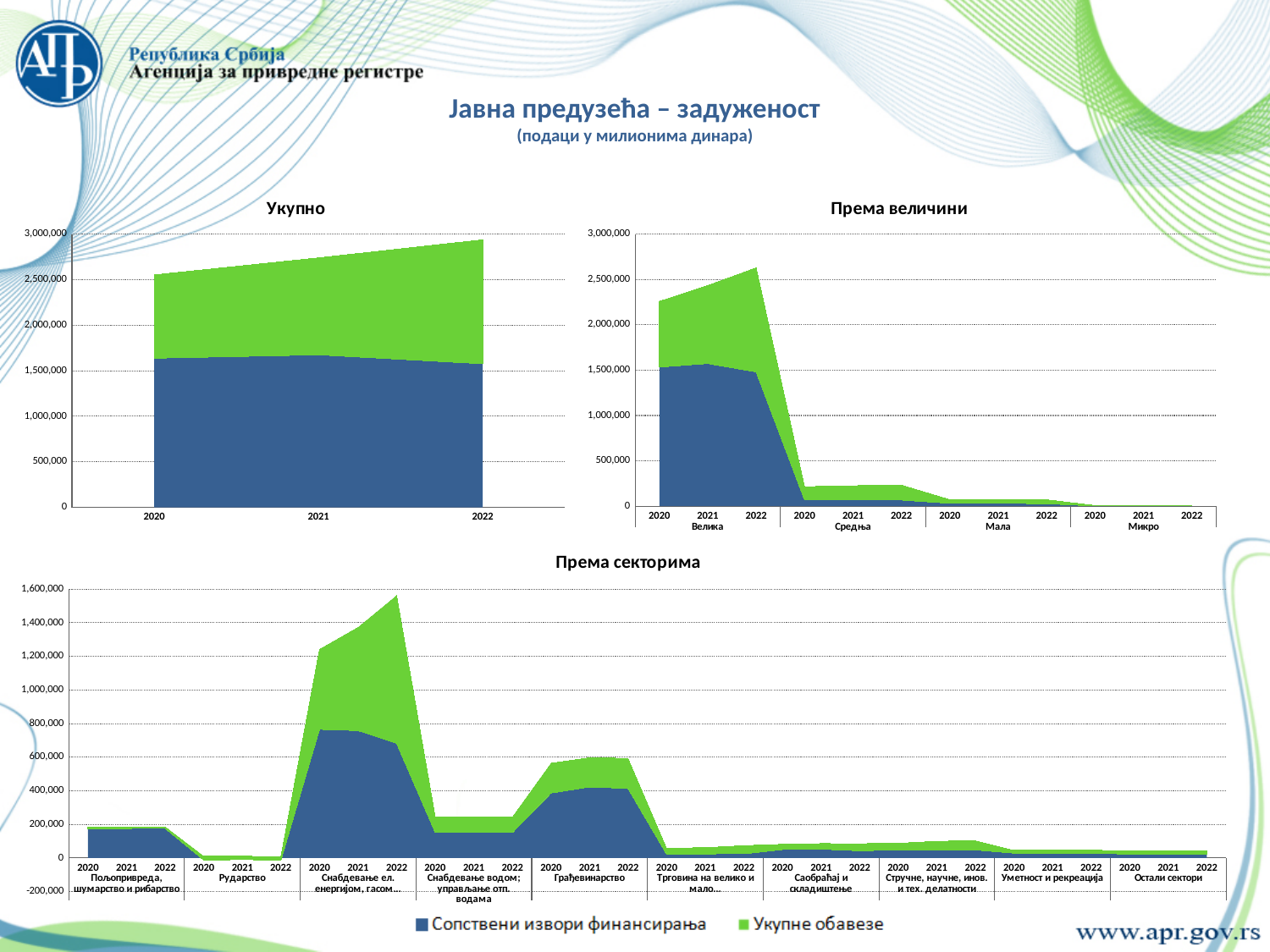
In the "Укупно" chart, does the stacked total rise or fall from 2020 to 2022? rise In the "Према величини" chart, how many size categories are shown along the x axis? 4 In the "Укупно" chart, is the value for Сопствени извори финансирања in 2020 greater or less than 2,000,000? less In the "Према величини" chart, which size category has the lowest values? Микро Which series is shown in green in the legend? Укупне обавезе In the "Према секторима" chart, which sector reaches the highest stacked value? Снабдевање ел. енергијом, гасом... In the "Према величини" chart, which size category has the highest values? Велика In the "Укупно" chart, how many years are plotted along the x axis? 3 What kind of chart is the "Укупно" chart? area chart In the "Укупно" chart, is the stacked total for 2022 greater or less than 2,500,000? greater How many series does the legend at the bottom of the slide list? 2 In the "Према секторима" chart, how many sector categories are shown along the x axis? 10